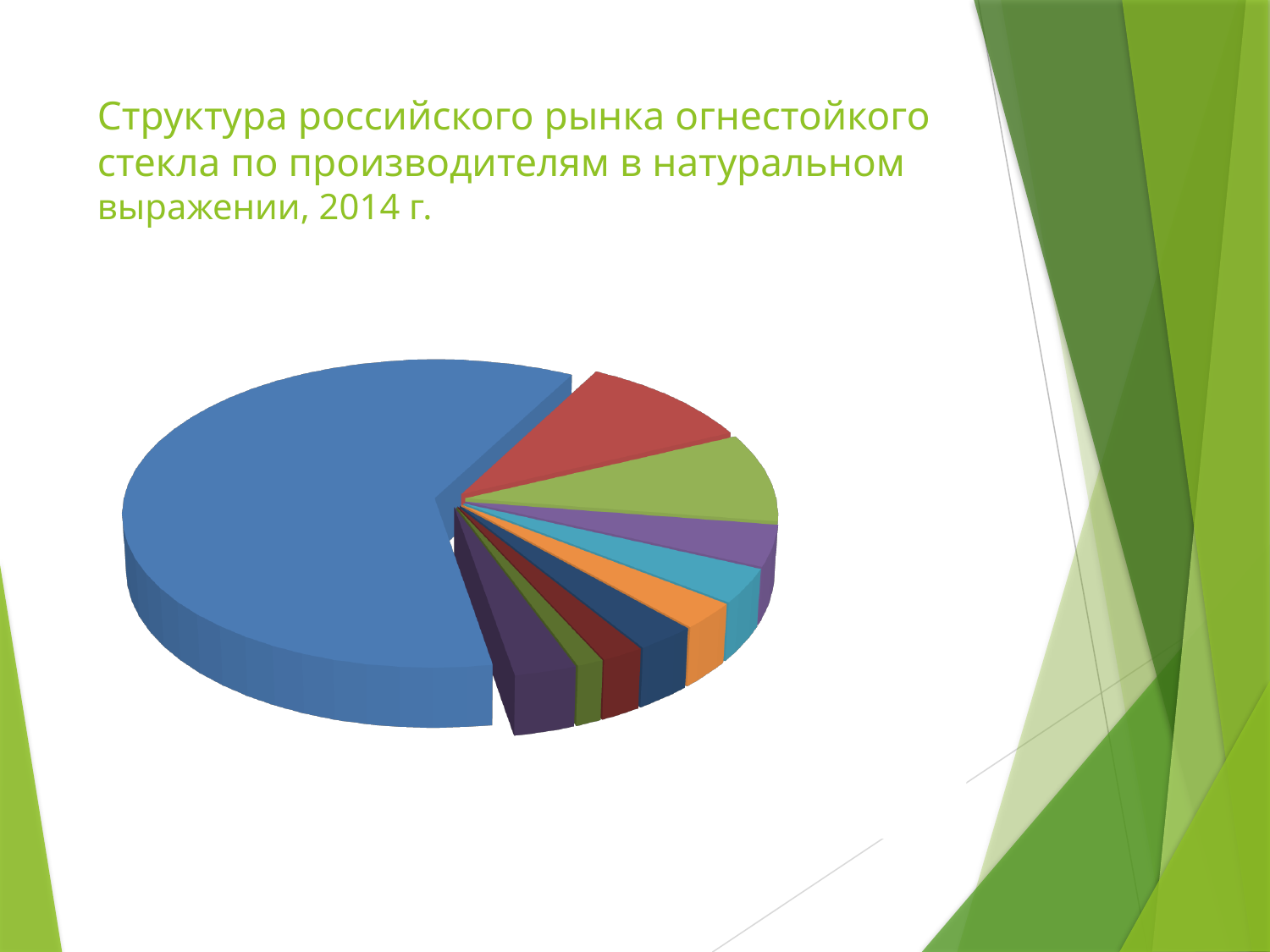
How many slices does the pie chart have? 10 Which is larger, the blue slice or the red slice? the blue slice Does the chart display a legend? No What is the title shown above the chart? Структура российского рынка огнестойкого стекла по производителям в натуральном выражении, 2014 г. Which year does the chart title refer to? 2014 Does the blue slice take up more or less than half of the pie? more Which colour slice is the largest in the pie chart? blue What kind of chart is shown on the slide? pie chart